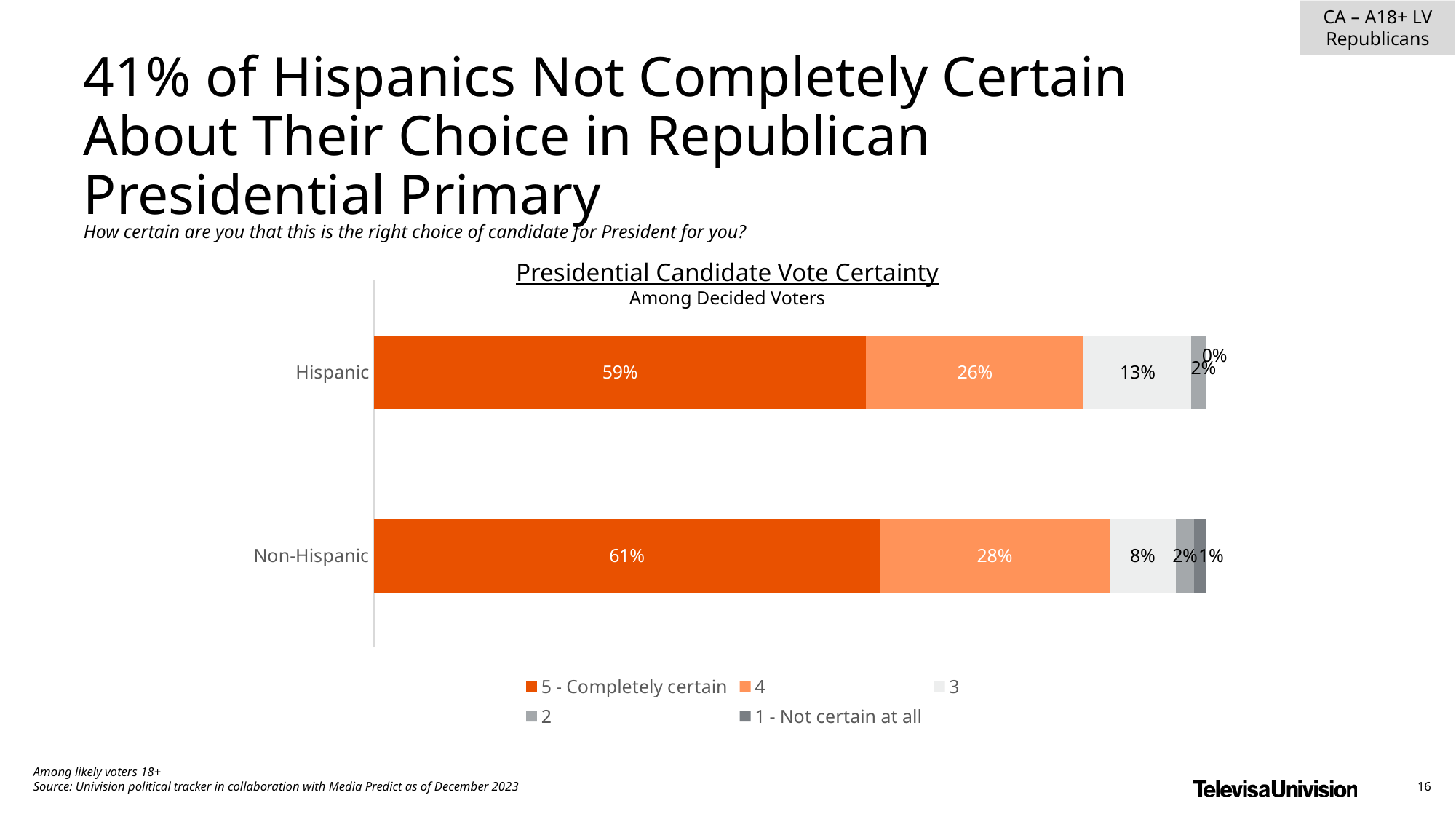
Which group has the larger share of "5 - Completely certain" voters, Hispanic or Non-Hispanic? Non-Hispanic What percentage of Hispanic decided voters are "5 - Completely certain" about their choice? 59% Which group has the larger share of "3" responses, Hispanic or Non-Hispanic? Hispanic How many series does the legend list? 5 What is the value for the "4" series for Hispanic voters? 26% What is the difference between the "3" values for Hispanic and Non-Hispanic voters? 5% What kind of chart is shown on the slide? Stacked bar chart What percentage of Non-Hispanic decided voters are "5 - Completely certain"? 61% What is the title of the chart? Presidential Candidate Vote Certainty How many groups (categories) are shown in the chart? 2 What is the value for the "3" series for Non-Hispanic voters? 8% What is the value for "1 - Not certain at all" for Non-Hispanic voters? 1%